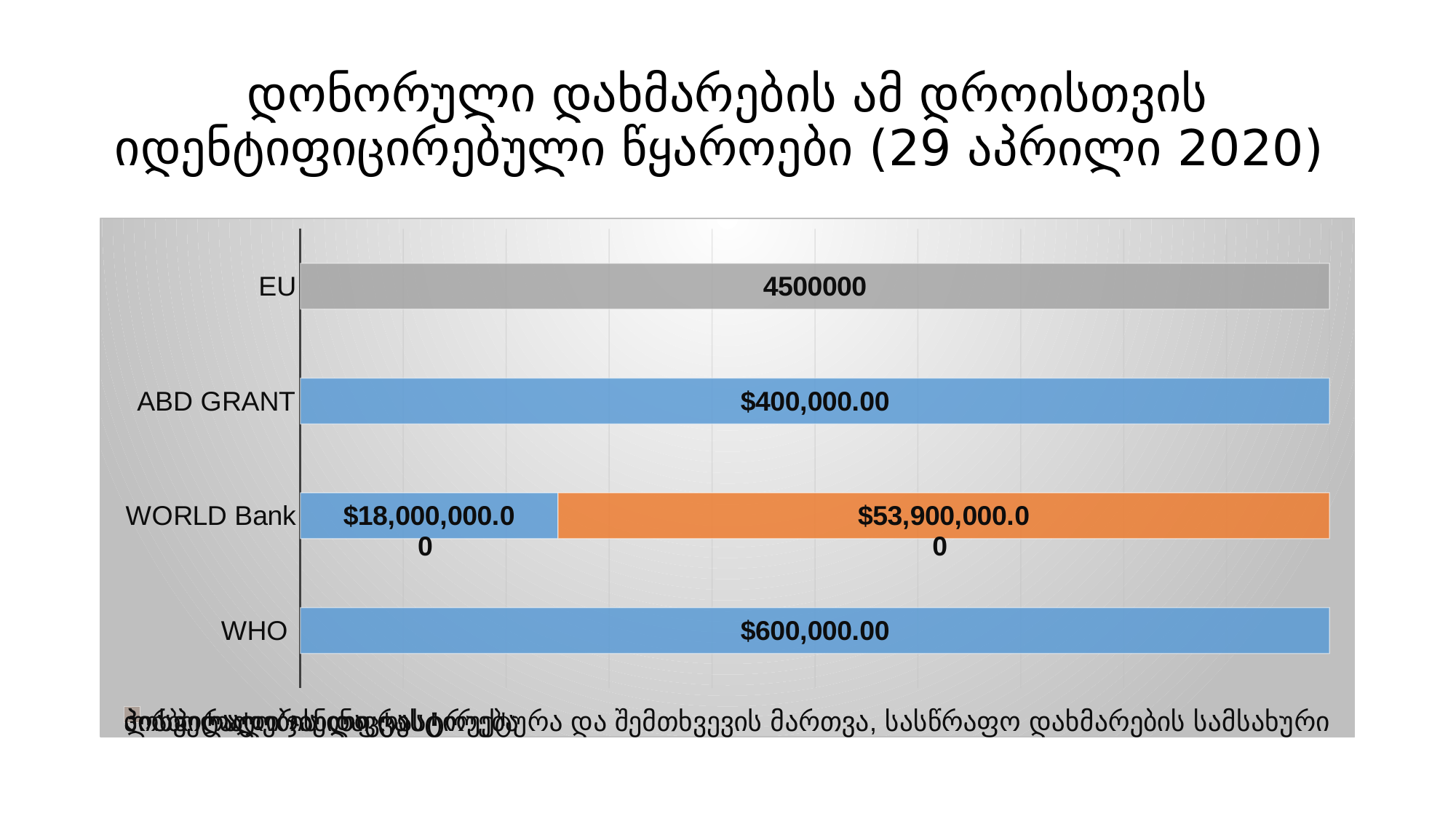
What is the difference between the two segments of the WORLD Bank bar? $35,900,000.00 What kind of chart is shown on the slide? Bar chart How many categories are shown on the chart? 4 What is the value of the blue (first) segment of the WORLD Bank bar? $18,000,000.00 What value is shown for WHO? $600,000.00 Which category has the smallest labelled value? ABD GRANT What is the total of the two segments of the WORLD Bank bar? $71,900,000.00 What value is shown for EU? 4500000 What value is shown for ABD GRANT? $400,000.00 Which category has the largest total value? WORLD Bank What is the value of the orange (second) segment of the WORLD Bank bar? $53,900,000.00 Which is larger, the value for WHO or the value for ABD GRANT? WHO